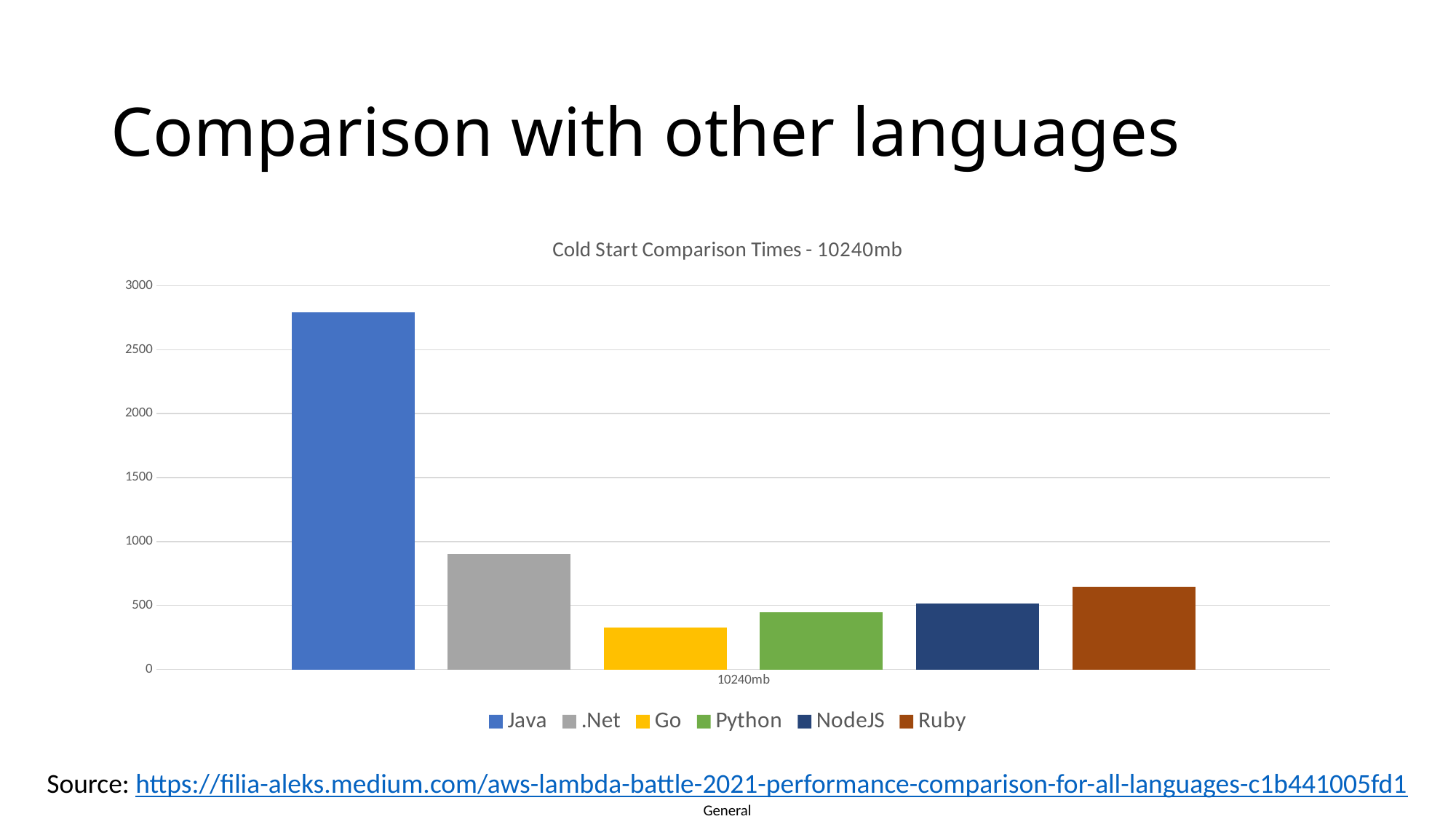
Is the value for Java greater or less than 2500? greater Which language has the lowest cold start time? Go Is the value for Ruby greater or less than 500? greater Is the value for Go greater or less than 500? less What kind of chart is shown on the slide? bar chart Which is larger, the value for Python or the value for Go? Python Which is larger, the value for .Net or the value for Ruby? .Net What is the title of the chart? Cold Start Comparison Times - 10240mb Which language has the highest cold start time? Java Which colour is used for the NodeJS bar? dark blue How many series does the legend list? 6